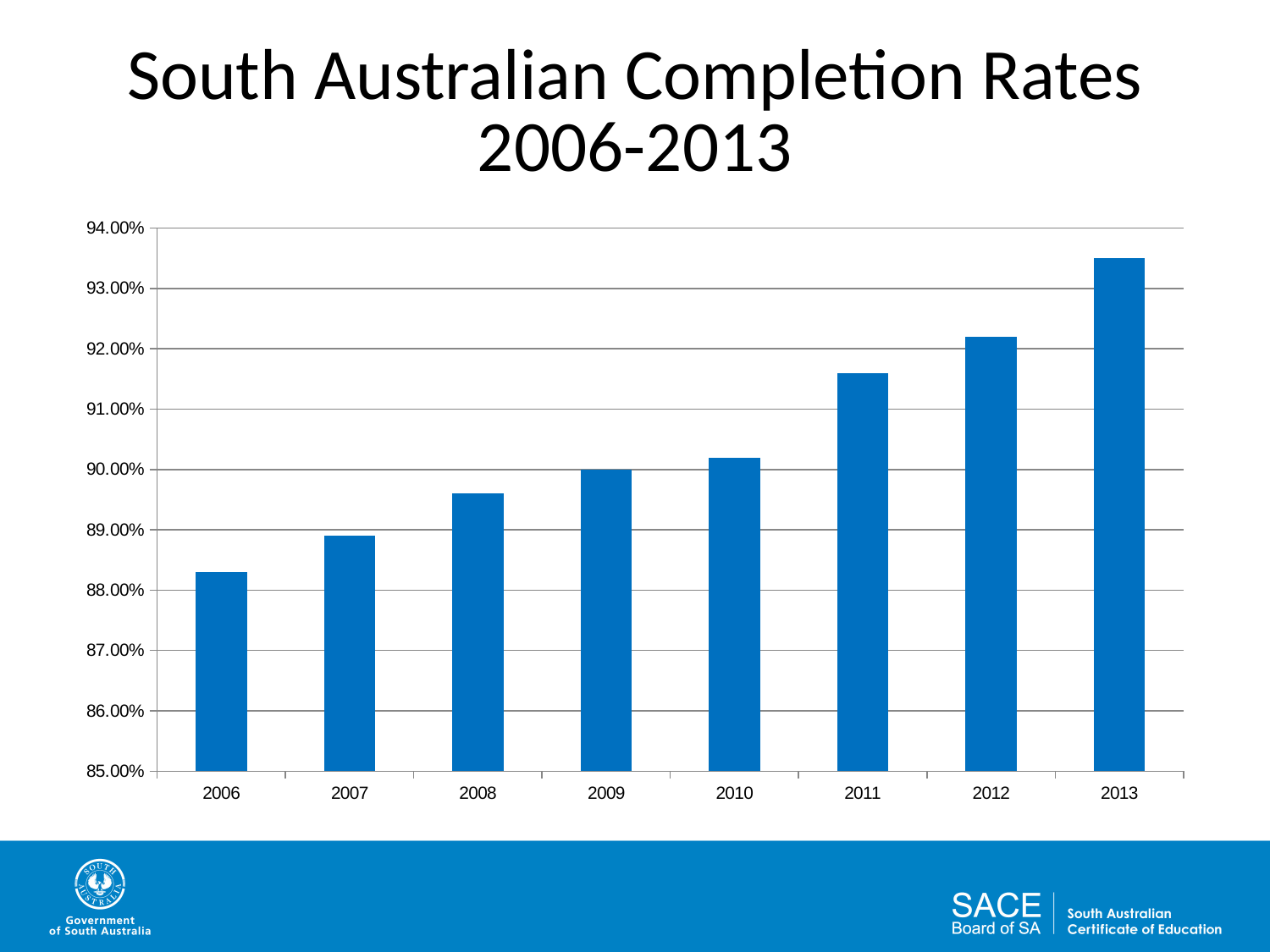
Is the completion rate for 2013 greater or less than 93.00%? greater What kind of chart is shown on the slide? bar chart Is the completion rate for 2012 greater or less than 93.00%? less Which year has the lowest completion rate? 2006 How many years are plotted on the x axis? 8 Is the completion rate for 2011 greater or less than 91.00%? greater What is the title of the chart on the slide? South Australian Completion Rates 2006-2013 Do the completion rates rise or fall from 2006 to 2013? rise Which year has the higher completion rate, 2008 or 2011? 2011 Which year has the highest completion rate? 2013